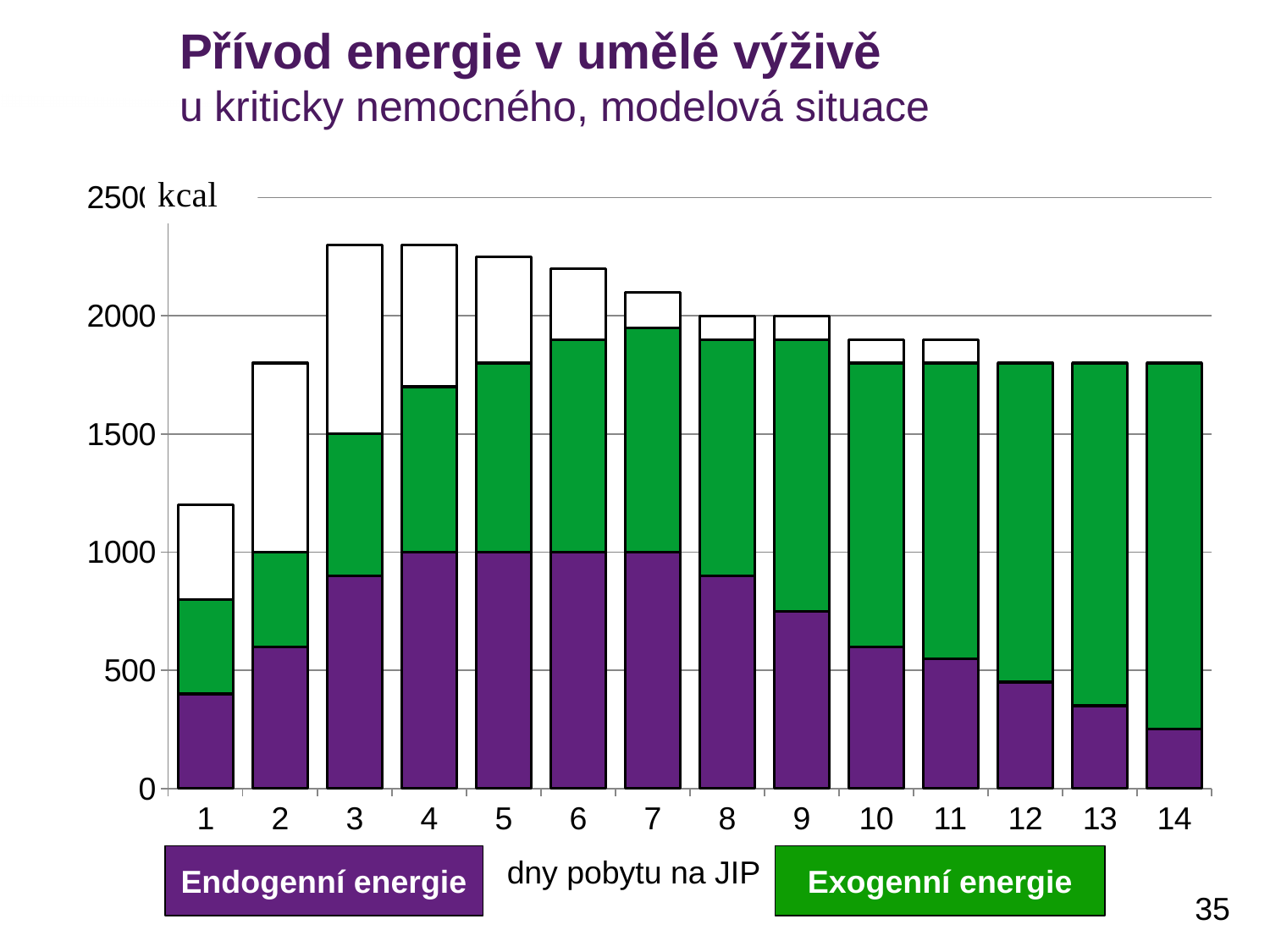
Is the total height of the bar for day 10 greater or less than 2000? less What kind of chart is shown on the slide? bar chart What is the label of the x axis? dny pobytu na JIP Which is larger, the Endogenní energie value for day 2 or for day 13? day 2 How many days (categories) are plotted on the x axis? 14 Is the total height of the bar for day 3 greater or less than 2000? greater Does the Endogenní energie value rise or fall from day 7 to day 14? fall Is the total height of the bar for day 1 greater or less than 1500? less Which series is shown in purple according to the legend? Endogenní energie Which day has the lowest total bar? 1